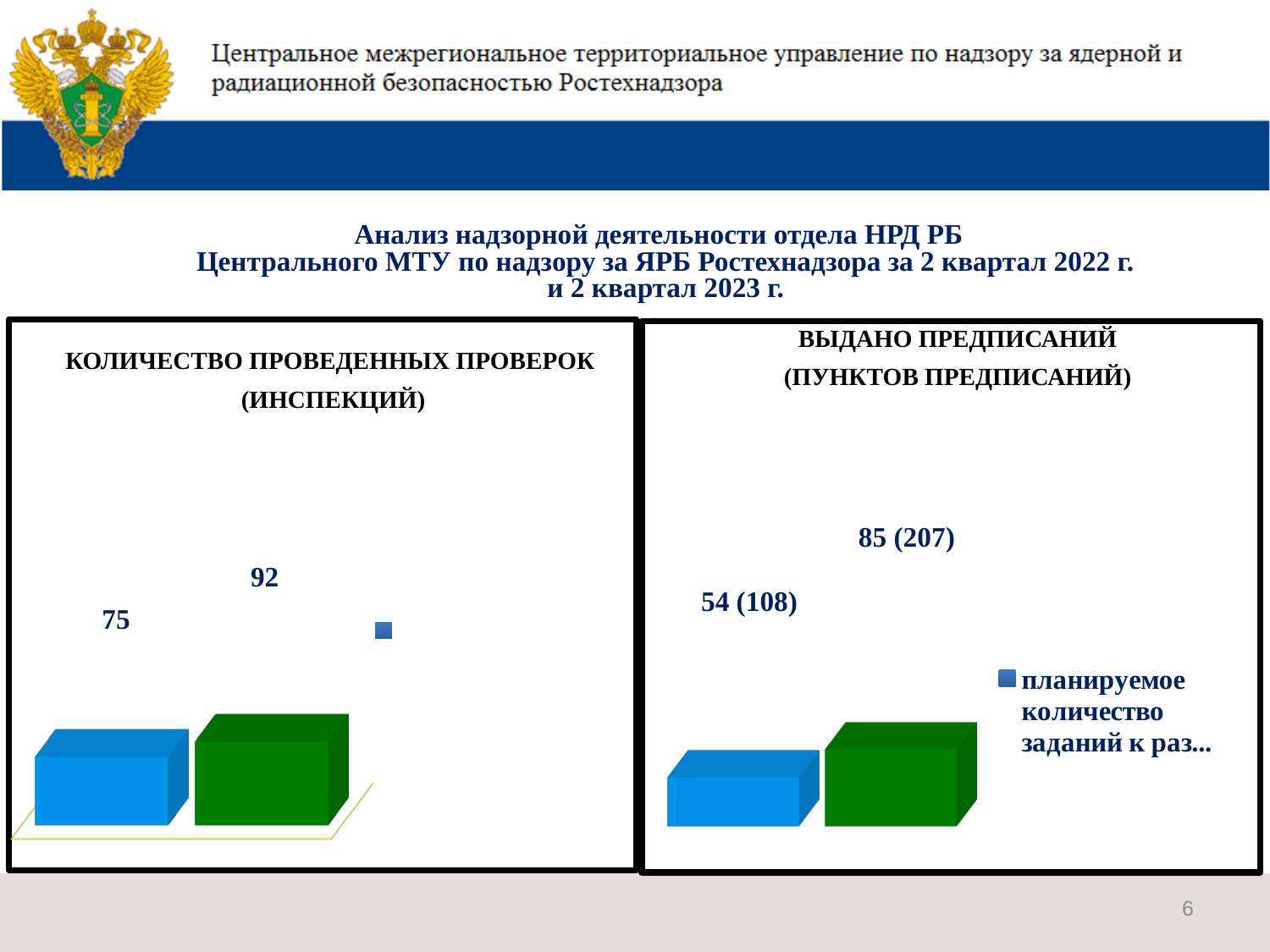
How many bars are plotted in the left chart (КОЛИЧЕСТВО ПРОВЕДЕННЫХ ПРОВЕРОК)? 2 In the left chart (КОЛИЧЕСТВО ПРОВЕДЕННЫХ ПРОВЕРОК), what value is shown for the green bar? 92 In the right chart (ВЫДАНО ПРЕДПИСАНИЙ), what label is shown for the green bar? 85 (207) In the right chart (ВЫДАНО ПРЕДПИСАНИЙ), what is the difference between the first numbers of the green bar (85) and the blue bar (54)? 31 What is the title of the left chart? КОЛИЧЕСТВО ПРОВЕДЕННЫХ ПРОВЕРОК (ИНСПЕКЦИЙ) In the left chart (КОЛИЧЕСТВО ПРОВЕДЕННЫХ ПРОВЕРОК), what value is shown for the blue bar? 75 What kind of chart is the right chart (ВЫДАНО ПРЕДПИСАНИЙ)? bar chart In the right chart (ВЫДАНО ПРЕДПИСАНИЙ), what label is shown for the blue bar? 54 (108) In the left chart (КОЛИЧЕСТВО ПРОВЕДЕННЫХ ПРОВЕРОК), which bar is higher, the blue one or the green one? the green one In the left chart (КОЛИЧЕСТВО ПРОВЕДЕННЫХ ПРОВЕРОК), what is the difference between the green bar and the blue bar? 17 What colour is the taller bar in the right chart (ВЫДАНО ПРЕДПИСАНИЙ)? green In the right chart (ВЫДАНО ПРЕДПИСАНИЙ), which bar has the lowest value? the blue bar (54 (108))